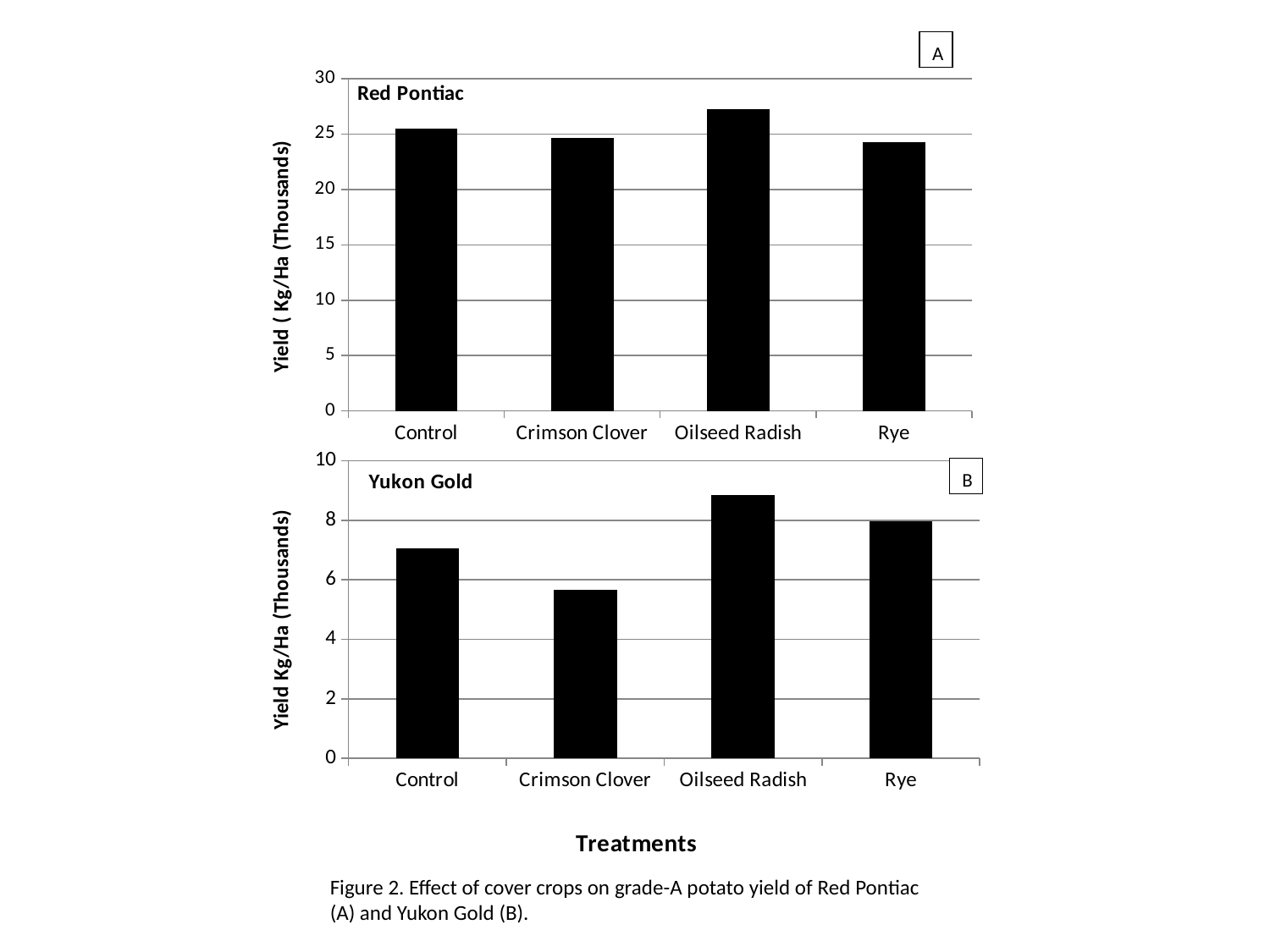
How many treatments are shown on the Yukon Gold chart (B)? 4 On the Yukon Gold chart (B), which has the larger yield, Control or Rye? Rye What is the y-axis label on the Yukon Gold chart (B)? Yield Kg/Ha (Thousands) On the Yukon Gold chart (B), is the yield for Crimson Clover greater or less than 6? less On the Yukon Gold chart (B), which treatment has the highest yield? Oilseed Radish What kind of chart is the Red Pontiac chart (A)? bar chart On the Red Pontiac chart (A), which treatment has the highest yield? Oilseed Radish On the Red Pontiac chart (A), is the yield for Oilseed Radish greater or less than 25? greater On the Yukon Gold chart (B), which treatment has the lowest yield? Crimson Clover On the Red Pontiac chart (A), is the yield for Rye greater or less than 25? less On the Red Pontiac chart (A), which has the larger yield, Control or Oilseed Radish? Oilseed Radish